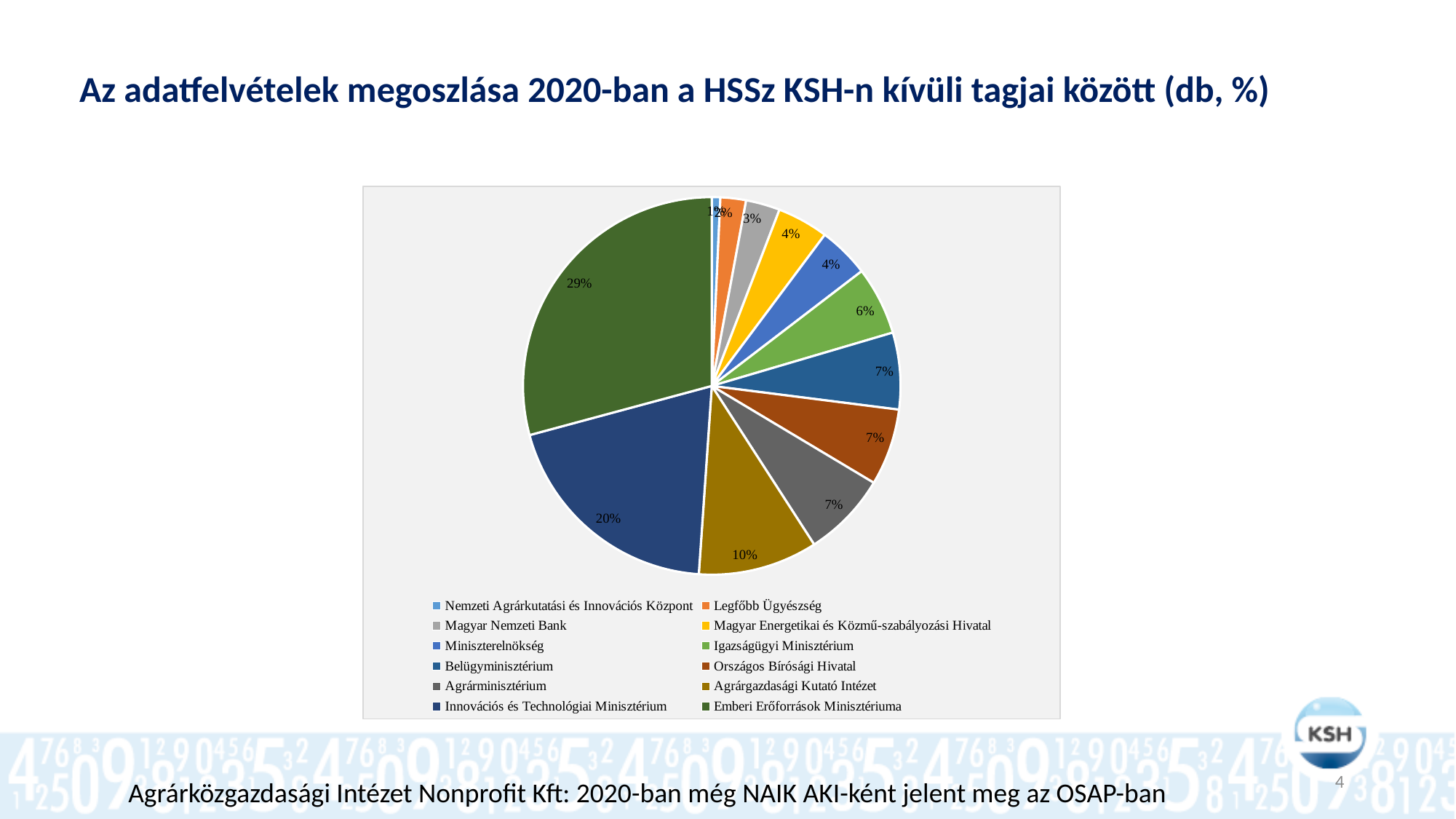
What share of the pie does Innovációs és Technológiai Minisztérium have? 20% How many categories does the legend list? 12 Which has a larger share, Agrárgazdasági Kutató Intézet or Belügyminisztérium? Agrárgazdasági Kutató Intézet What kind of chart is shown on the slide? pie chart What share of the pie does Magyar Nemzeti Bank have? 3% What is the title of the slide containing the chart? Az adatfelvételek megoszlása 2020-ban a HSSz KSH-n kívüli tagjai között (db, %) What share of the pie does Agrárgazdasági Kutató Intézet have? 10% What is the difference in percentage points between the shares of Emberi Erőforrások Minisztériuma and Innovációs és Technológiai Minisztérium? 9 Which category has the largest slice of the pie? Emberi Erőforrások Minisztériuma Which category has the smallest slice of the pie? Nemzeti Agrárkutatási és Innovációs Központ